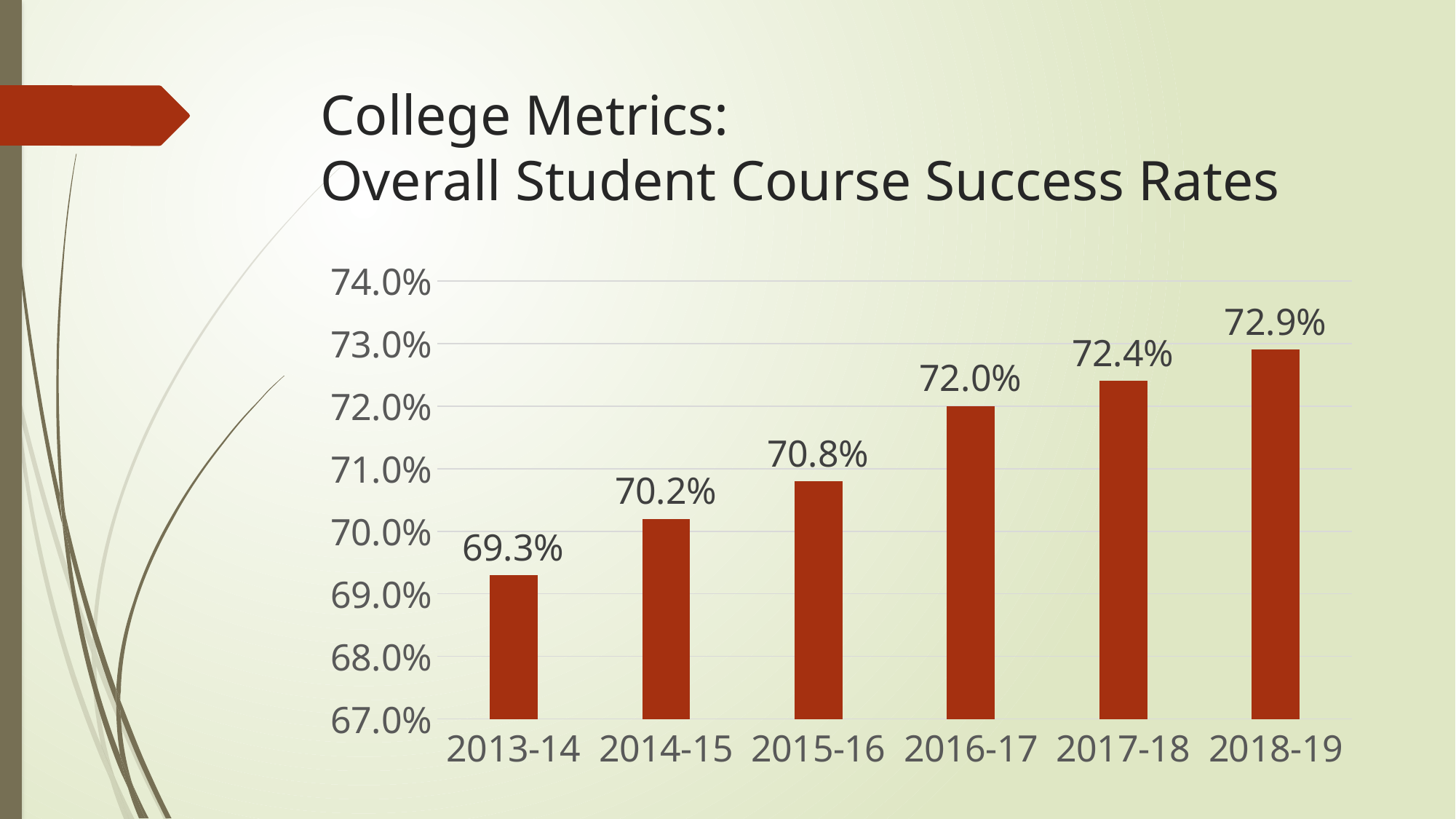
How many academic years are shown on the chart? 6 Which year has a higher course success rate, 2014-15 or 2017-18? 2017-18 Which academic year has the highest course success rate? 2018-19 Which academic year has the lowest course success rate? 2013-14 What is the difference between the course success rates for 2018-19 and 2013-14? 3.6% What is the overall student course success rate for 2018-19? 72.9% What is the difference between the course success rates for 2015-16 and 2014-15? 0.6% What kind of chart is shown on the slide? bar chart What is the overall student course success rate for 2013-14? 69.3% Is the course success rate for 2015-16 greater or less than 71.0%? less What is the overall student course success rate for 2016-17? 72.0% Do the course success rates rise or fall from 2013-14 to 2018-19? rise